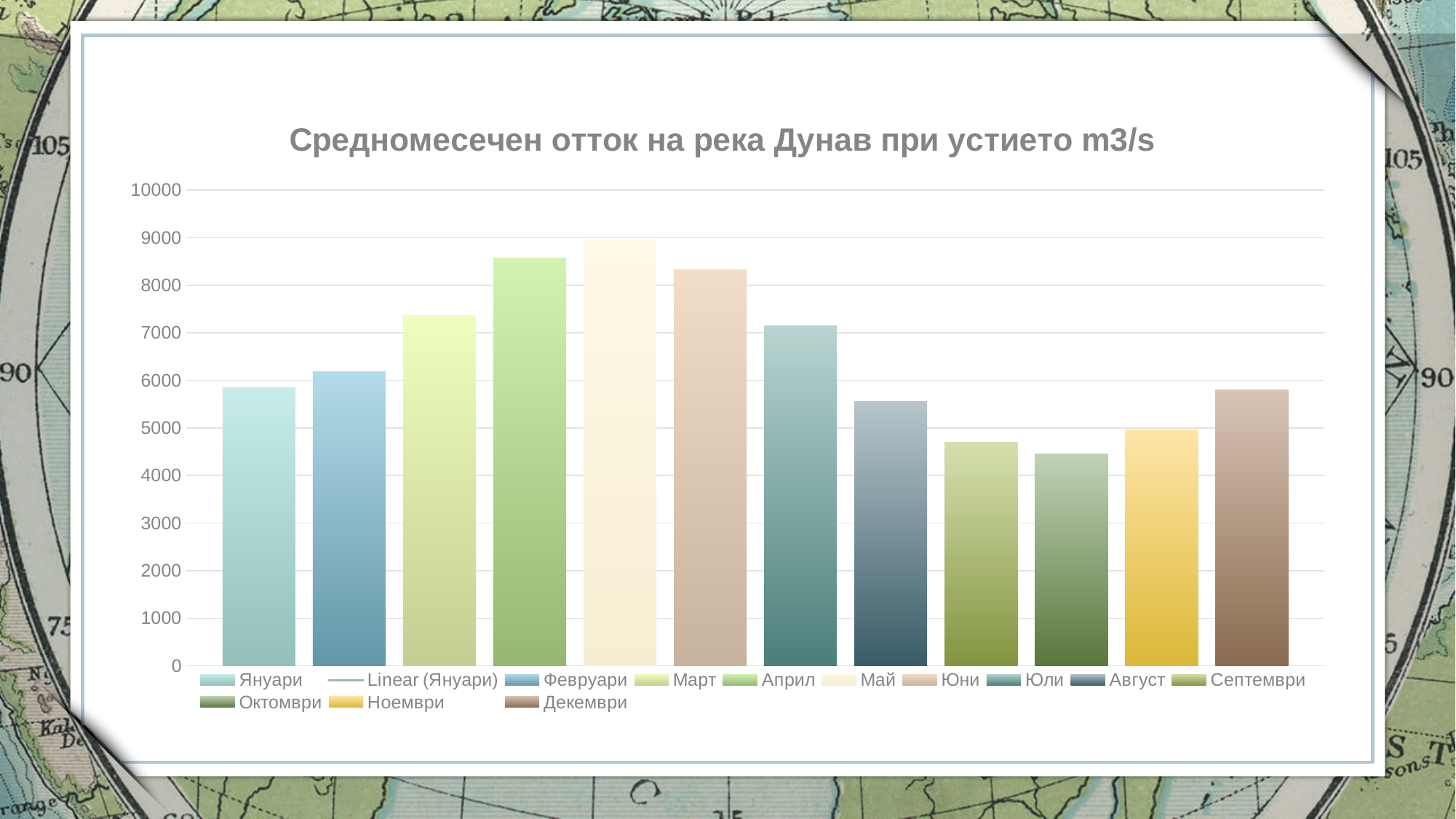
Which month has the lowest bar? Октомври Which is larger, the value for Септември or the value for Октомври? Септември How many bars are plotted on the chart? 12 Is the value for Май greater or less than 8000? greater Is the value for Декември greater or less than 6000? less How many entries does the legend list? 13 Which is larger, the value for Април or the value for Юни? Април What is the title of the chart? Средномесечен отток на река Дунав при устието m3/s Which month has the highest bar? Май What kind of chart is shown on the slide? bar chart Is the value for Март greater or less than 7000? greater